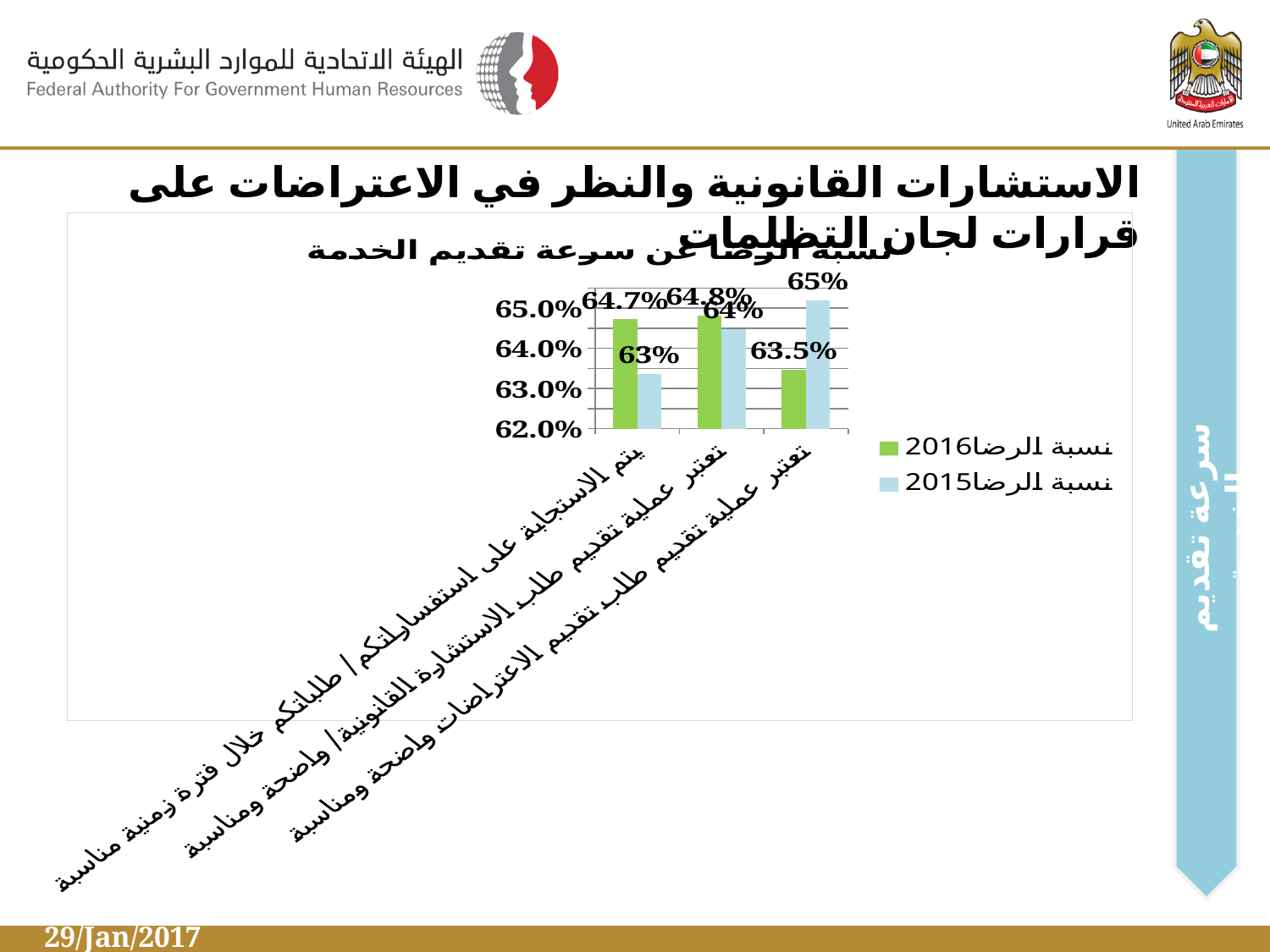
What kind of chart is shown on the slide? bar chart What is the 2016 satisfaction rate for the second category, 'تعتبر عملية تقديم طلب الاستشارة القانونية/ واضحة ومناسبة'? 64.8% For the third category, 'تعتبر عملية تقديم طلب تقديم الاعتراضات واضحة ومناسبة', which is larger: the 2016 rate or the 2015 rate? 2015 rate What is the 2015 satisfaction rate for the third category, 'تعتبر عملية تقديم طلب تقديم الاعتراضات واضحة ومناسبة'? 65% Which category has the lowest 2015 satisfaction rate (نسبة الرضا2015)? يتم الاستجابة على استفساراتكم / طلباتكم خلال فترة زمنية مناسبة What is the 2015 satisfaction rate (نسبة الرضا2015) for the first category, 'يتم الاستجابة على استفساراتكم / طلباتكم خلال فترة زمنية مناسبة'? 63% What is the 2016 satisfaction rate (نسبة الرضا2016) for the first category, 'يتم الاستجابة على استفساراتكم / طلباتكم خلال فترة زمنية مناسبة'? 64.7% For the first category, how much higher is the 2016 satisfaction rate than the 2015 rate? 1.7 percentage points What colour are the bars for the series نسبة الرضا2016? green How many series does the chart legend list? 2 How many categories are plotted along the x axis of the chart? 3 What is the 2016 satisfaction rate for the third category, 'تعتبر عملية تقديم طلب تقديم الاعتراضات واضحة ومناسبة'? 63.5%